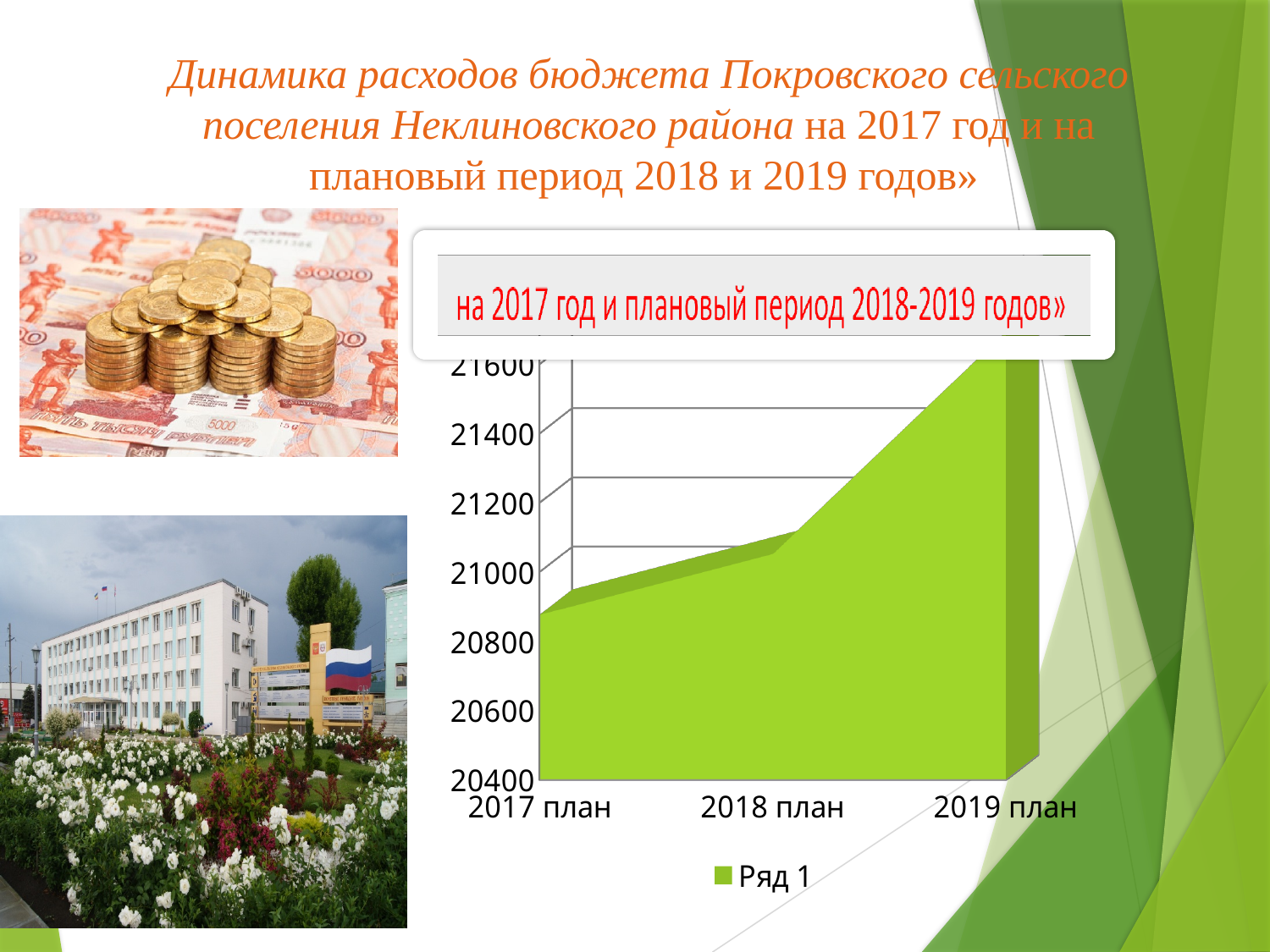
Which category has the highest value in the chart? 2019 план Is the value for 2017 план greater or less than 21000? less Is the value for 2017 план greater or less than 20800? greater Which is larger, the value for 2019 план or the value for 2017 план? 2019 план What is the name of the series shown in the chart legend? Ряд 1 Is the value for 2018 план greater or less than 20800? greater Do the values in the chart rise or fall from 2017 план to 2019 план? rise Which category has the lowest value in the chart? 2017 план How many categories are shown on the x axis of the chart? 3 How many series does the chart legend list? 1 What kind of chart is shown on the slide? area chart